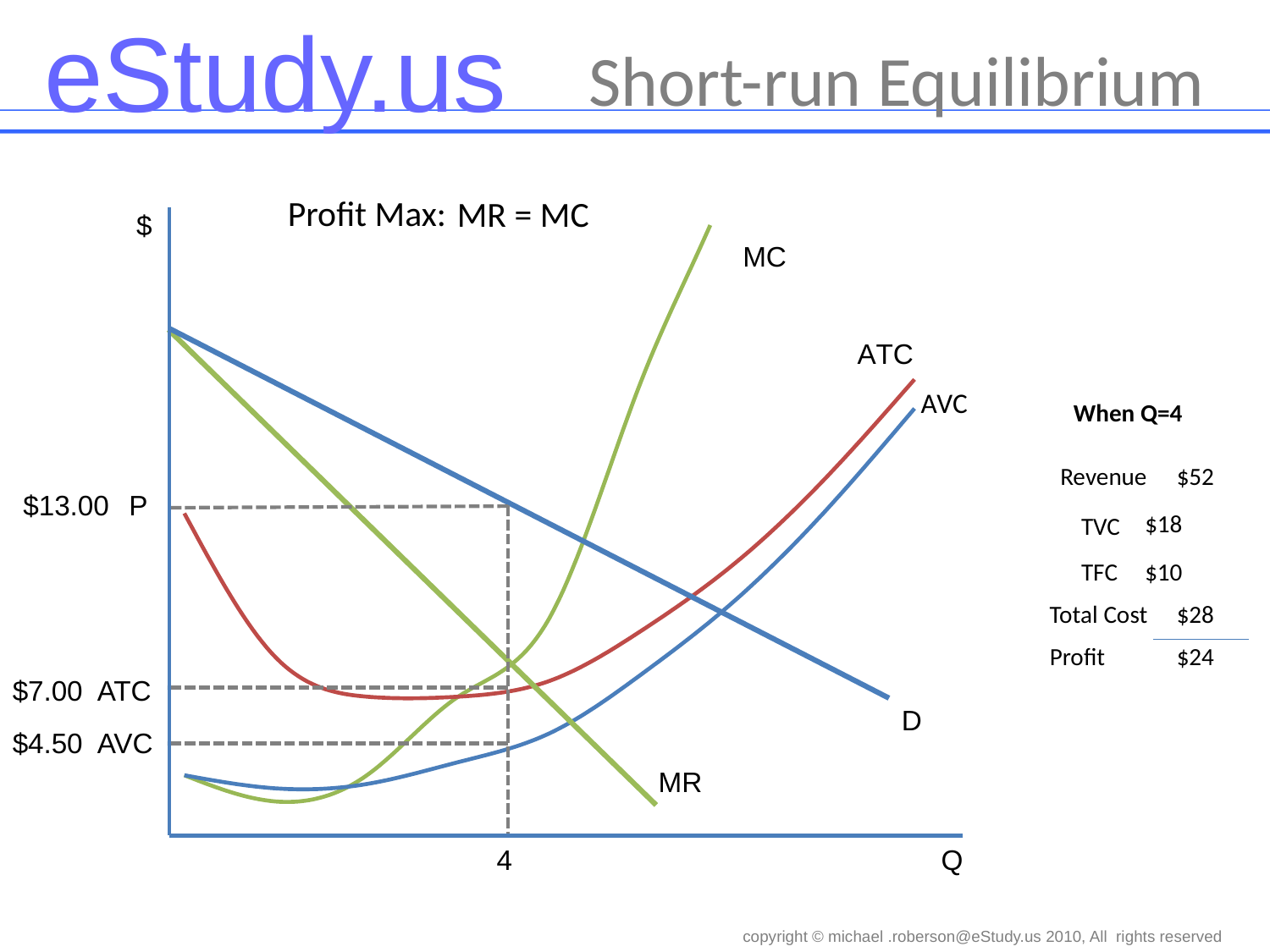
At Q = 4, which is larger, ATC or AVC? ATC What is the title printed above the chart? Profit Max: MR = MC What quantity is marked on the Q axis where the dashed lines meet it? 4 What is the value of AVC shown on the chart at Q = 4? $4.50 What is the difference between the price P and ATC at Q = 4? $6.00 What kind of chart is shown on the slide? Line chart What is the difference between ATC and AVC at Q = 4? $2.50 What is the value of ATC shown on the chart at Q = 4? $7.00 At Q = 4, which is larger, the price P or ATC? P How many labeled curves are drawn on the chart? 5 What is the price (P) shown on the chart at Q = 4? $13.00 Does the demand curve D rise or fall as Q increases? Fall